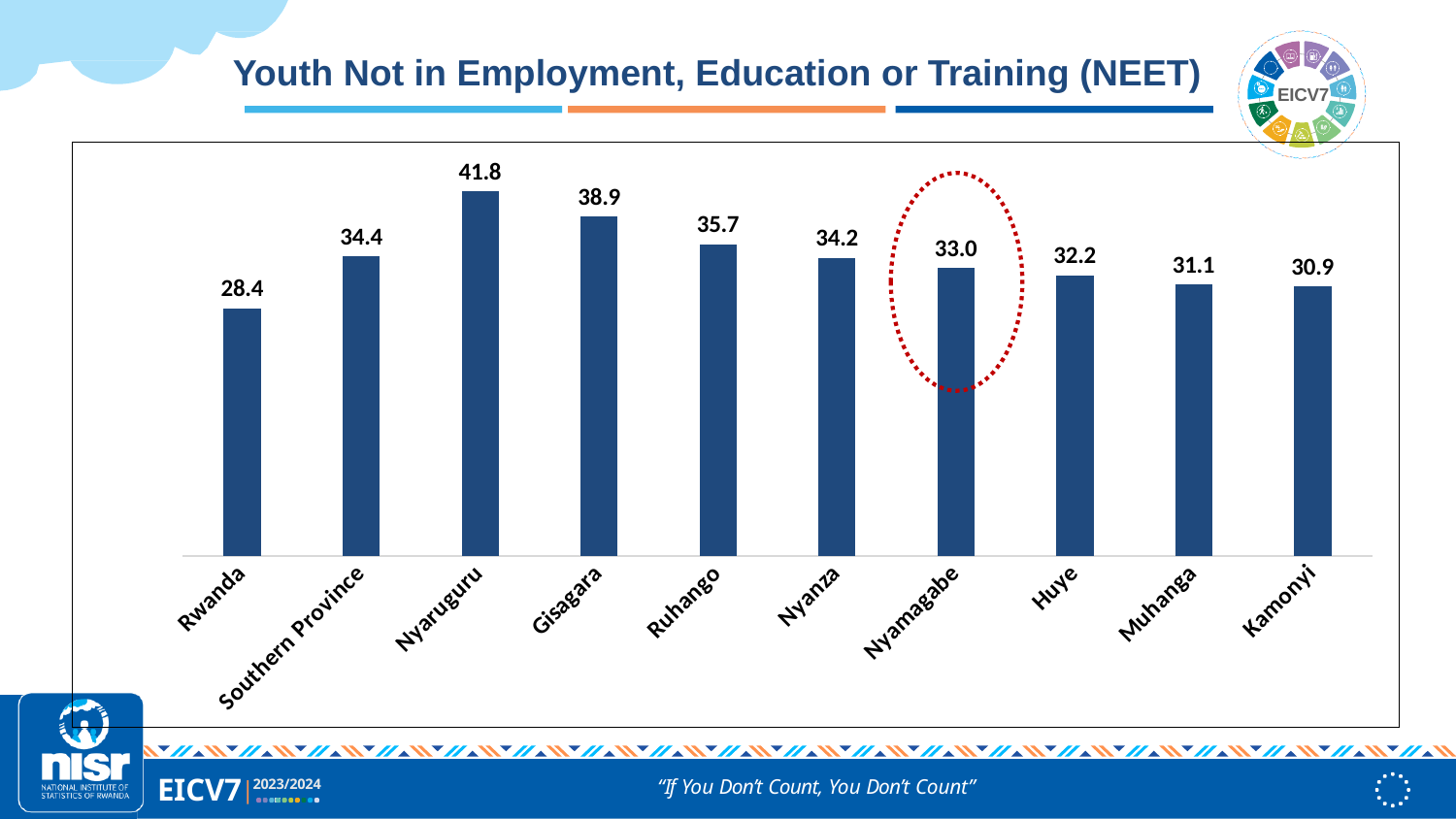
What kind of chart is shown on the slide? Bar chart What is the NEET value for Nyaruguru? 41.8 What is the difference between the NEET values for Southern Province and Rwanda? 6.0 What is the NEET value for Rwanda? 28.4 Which category has the lowest NEET value? Rwanda How many categories are shown on the chart? 10 Which category has the highest NEET value? Nyaruguru What is the difference between the NEET values for Nyaruguru and Rwanda? 13.4 What is the NEET value for Nyamagabe, the bar circled in red? 33.0 Which has a higher NEET value, Huye or Kamonyi? Huye Which has a higher NEET value, Gisagara or Ruhango? Gisagara Which bar on the chart is highlighted with a red dotted circle? Nyamagabe